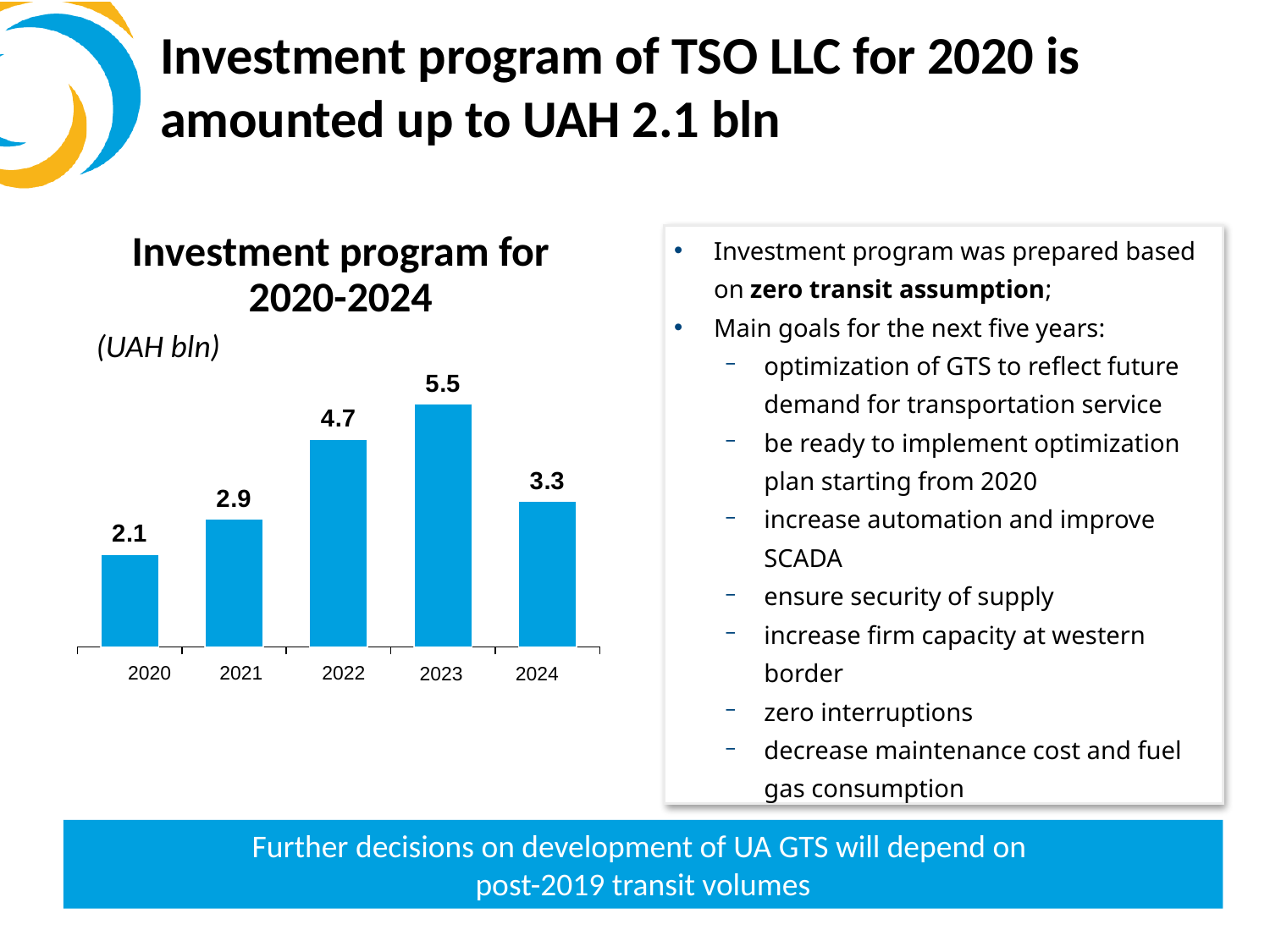
What kind of chart is shown on the slide? bar chart What is the difference between the values for 2023 and 2022? 0.8 What is the investment program value for 2022? 4.7 What is the investment program value for 2020? 2.1 What is the difference between the values for 2021 and 2020? 0.8 What is the investment program value for 2024? 3.3 What unit is the chart's data given in? UAH bln Which year has the highest investment program value? 2023 Which is larger, the value for 2024 or the value for 2021? 2024 How many years are shown on the chart? 5 Which year has the lowest investment program value? 2020 Do the values rise or fall from 2020 to 2023? rise